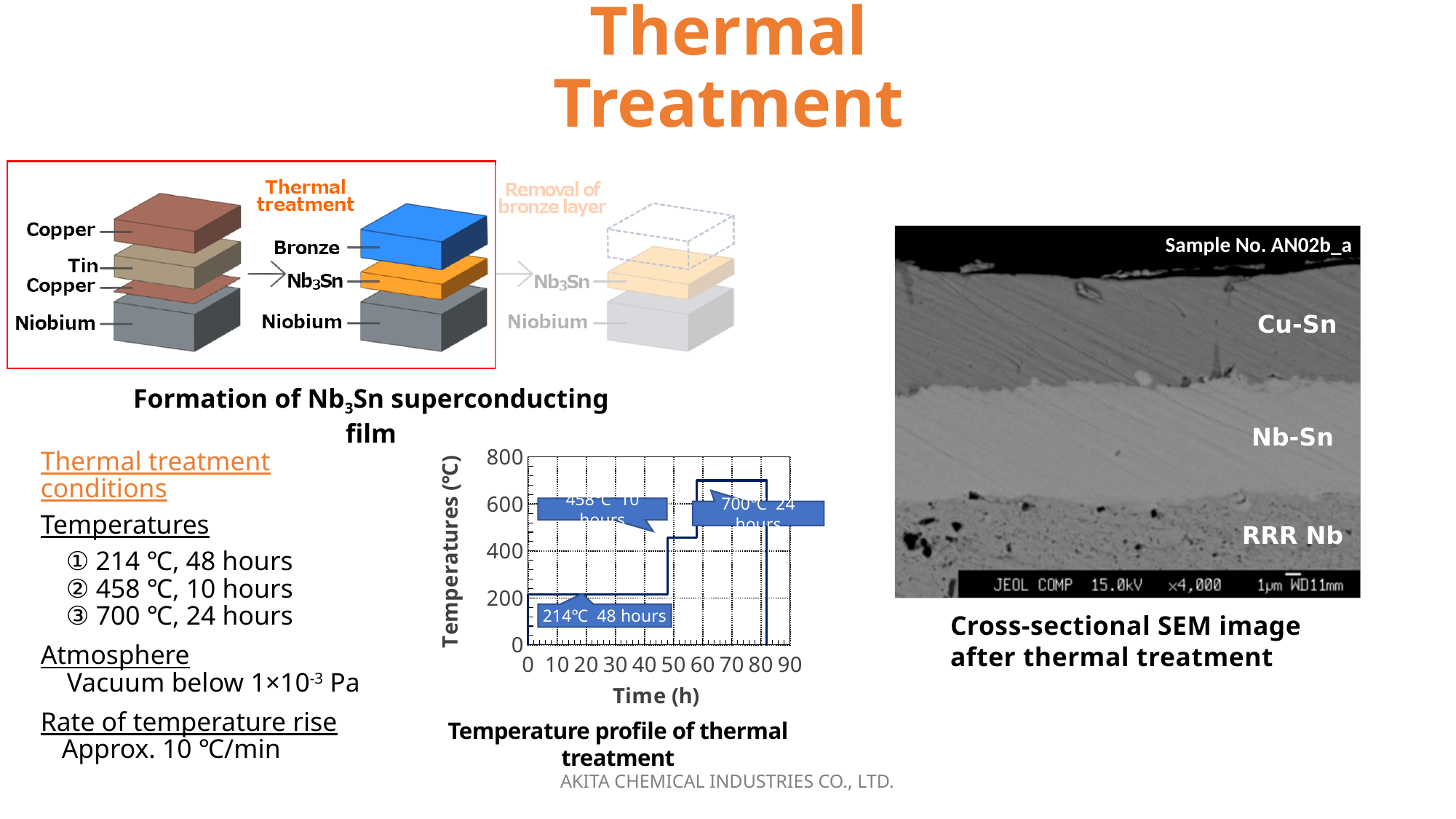
In the temperature profile chart, does the temperature generally rise or fall as time increases from 0 to 80 hours? rise In the temperature profile chart, what is the difference between the highest and lowest held temperatures? 486℃ In the temperature profile chart, what temperature is held during the first stage, according to the callout? 214℃ In the temperature profile chart, what is the label of the y axis? Temperatures (℃) In the temperature profile chart, how long is the 700℃ stage held? 24 hours In the temperature profile chart, how long is the 214℃ stage held, according to the callout? 48 hours In the temperature profile chart, which stage has the lowest temperature? 214℃, 48 hours What kind of chart is the 'Temperature profile of thermal treatment'? line chart In the temperature profile chart, what is the label of the x axis? Time (h) In the temperature profile chart, which stage has the highest temperature? 700℃, 24 hours In the temperature profile chart, what temperature is held for 10 hours? 458℃ In the temperature profile chart, how many temperature stages are labelled? 3